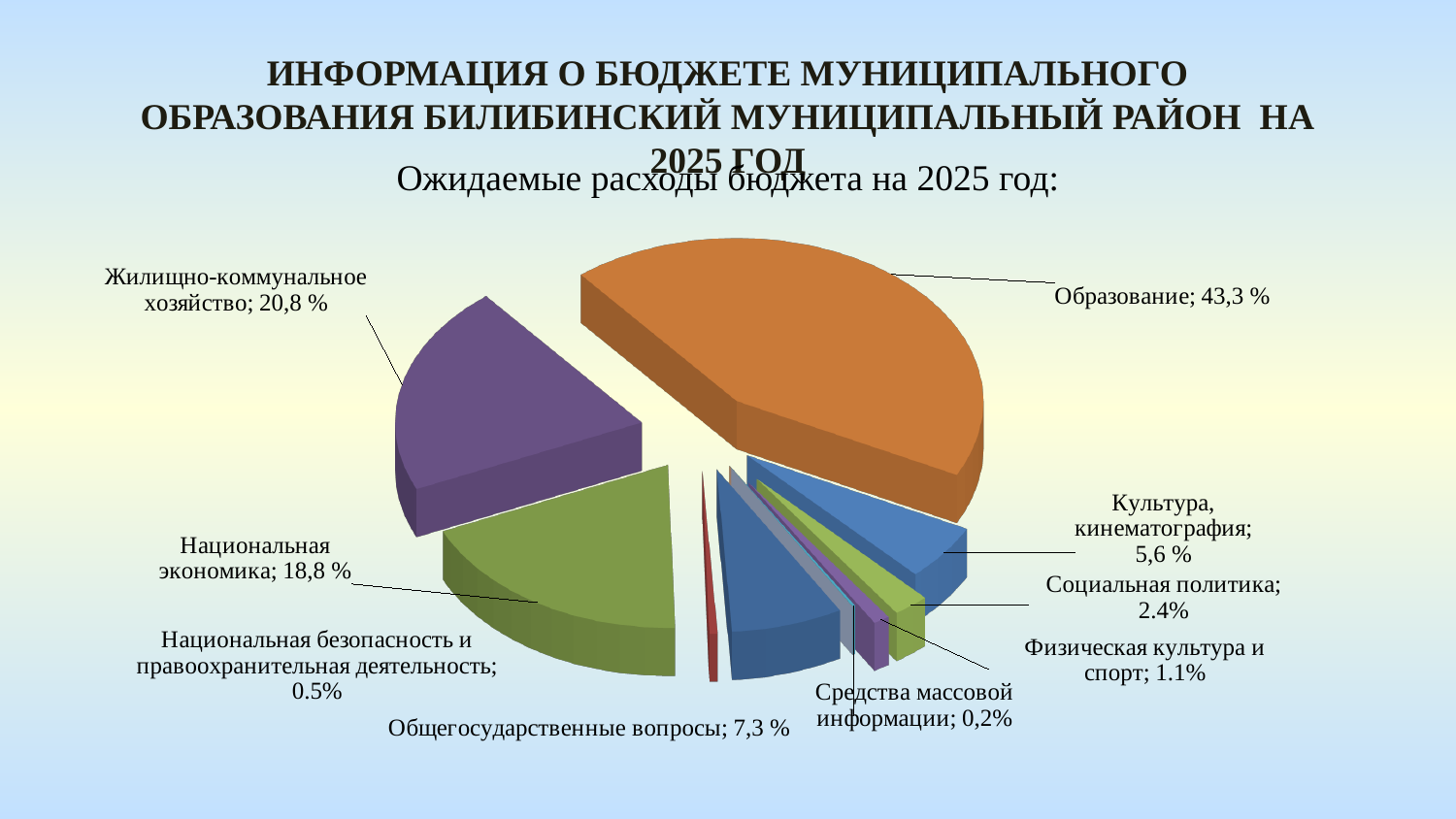
What share is shown for Средства массовой информации? 0,2% Which category has the smallest share of the pie? Средства массовой информации What percentage is labelled for Социальная политика? 2.4% How many categories are shown in the pie chart? 9 What is the difference in percentage points between Образование (43,3 %) and Жилищно-коммунальное хозяйство (20,8 %)? 22,5 What share of expected 2025 budget expenditures goes to Образование? 43,3 % What is the subtitle of the chart on the slide? Ожидаемые расходы бюджета на 2025 год: What type of chart is used on the slide? Pie chart Which is larger: the share for Национальная экономика or for Общегосударственные вопросы? Национальная экономика What share is shown for Жилищно-коммунальное хозяйство? 20,8 % Which category has the largest share of the pie? Образование What percentage is labelled for Национальная экономика? 18,8 %